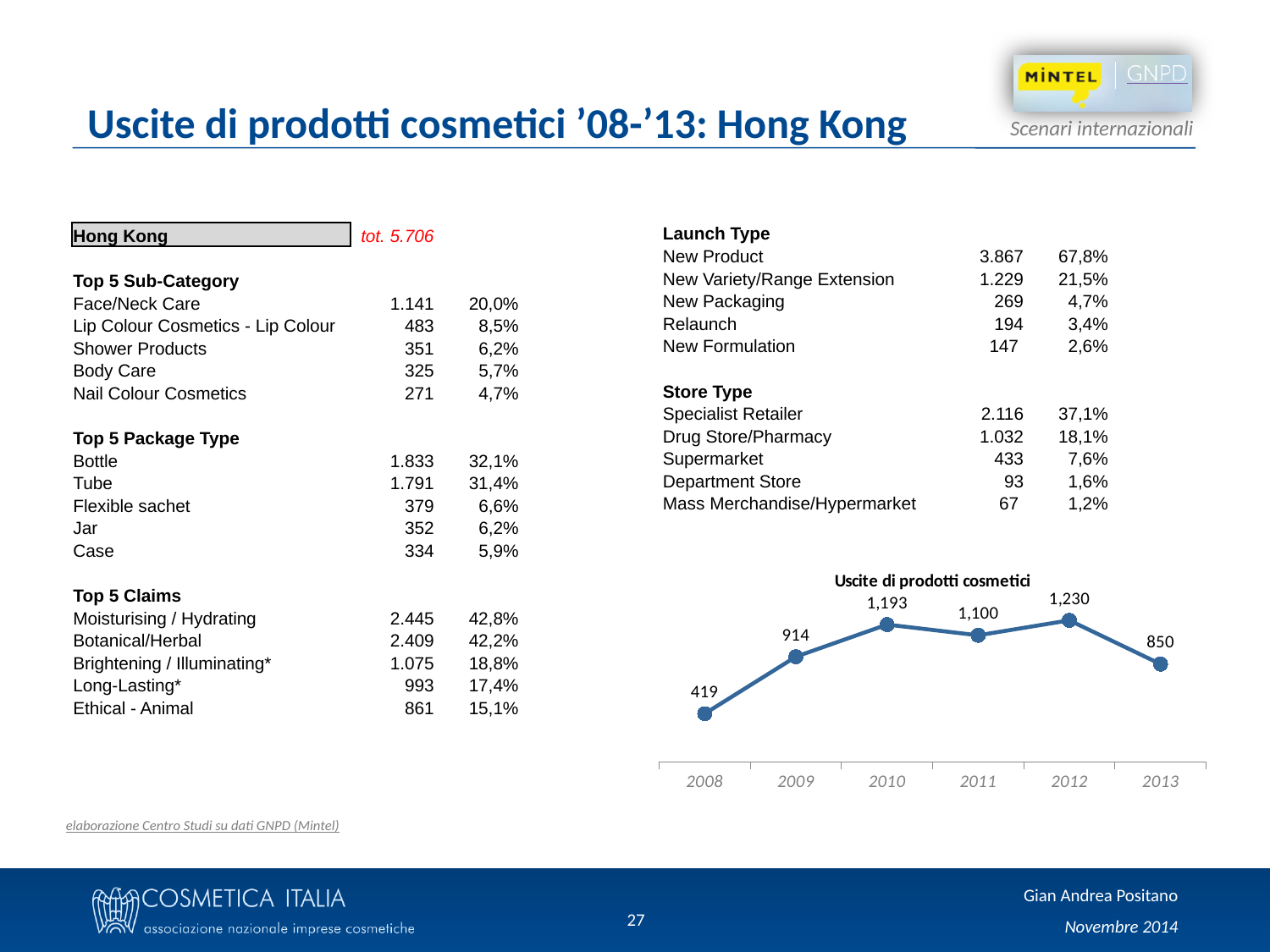
What is the value for 2010 in the chart? 1,193 What type of chart is shown on the slide? line chart Which is larger, the value for 2010 or the value for 2011? 2010 Does the value rise or fall from 2012 to 2013? fall What is the value for 2008 in the chart? 419 What is the title of the chart? Uscite di prodotti cosmetici How many years are plotted on the x axis of the chart? 6 What is the value for 2013 in the chart? 850 What is the difference between the values for 2009 and 2008? 495 Which year has the lowest value in the chart? 2008 Which year has the highest value in the chart? 2012 What is the difference between the values for 2012 and 2013? 380